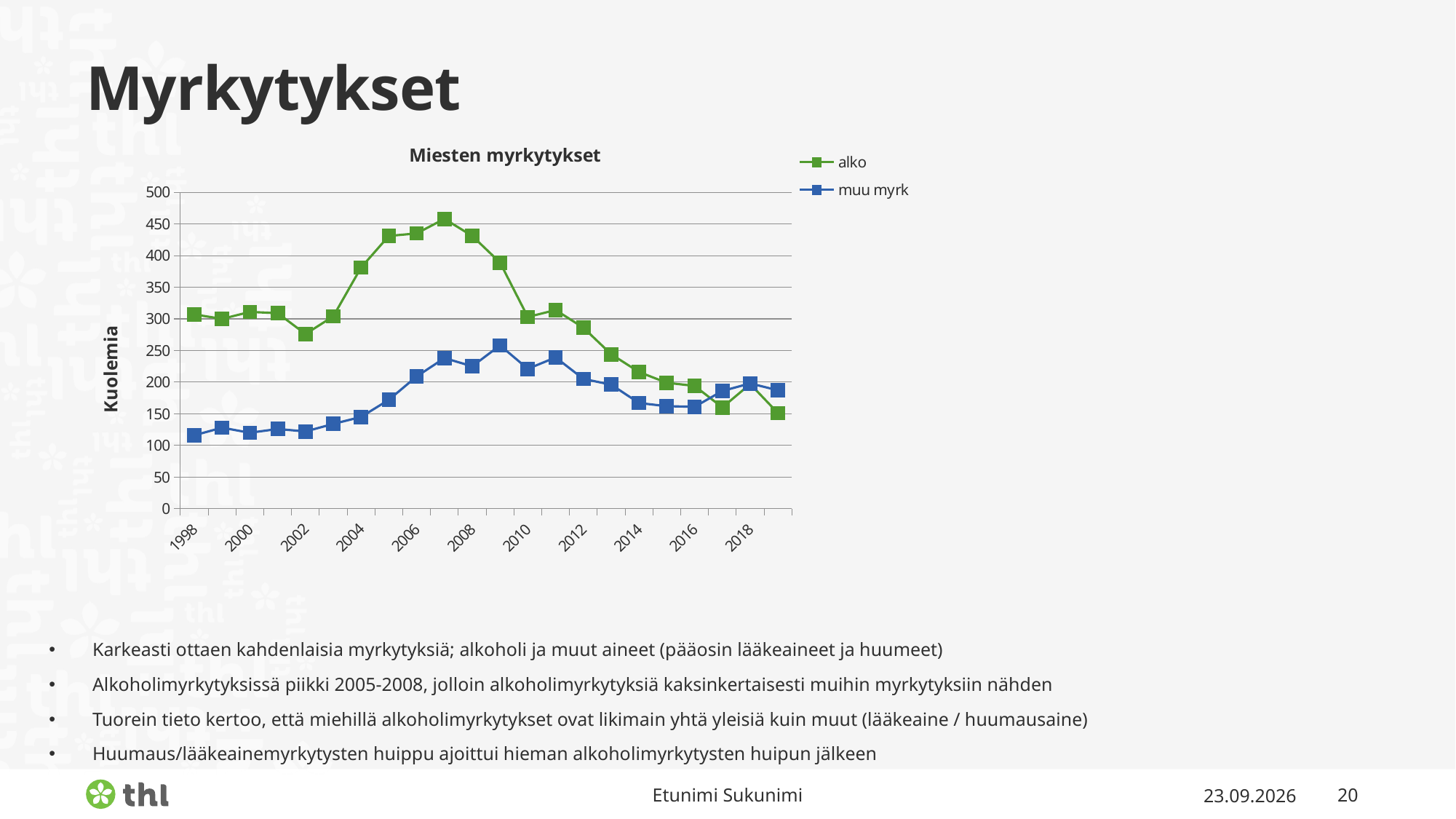
Which series has the larger value in 2007, alko or muu myrk? alko Is the value for muu myrk in 1998 greater or less than 150? less Does the alko series rise or fall from 2007 to 2019? fall Is the value for alko in 2007 greater or less than 400? greater How many series does the legend list? 2 In which year does the muu myrk series reach its highest value? 2009 What is the title of the chart? Miesten myrkytykset In which year is the alko series at its lowest value? 2019 What is the label of the y axis? Kuolemia Is the value for alko in 2019 greater or less than 200? less In which year does the alko series reach its highest value? 2007 What kind of chart is shown on the slide? line chart